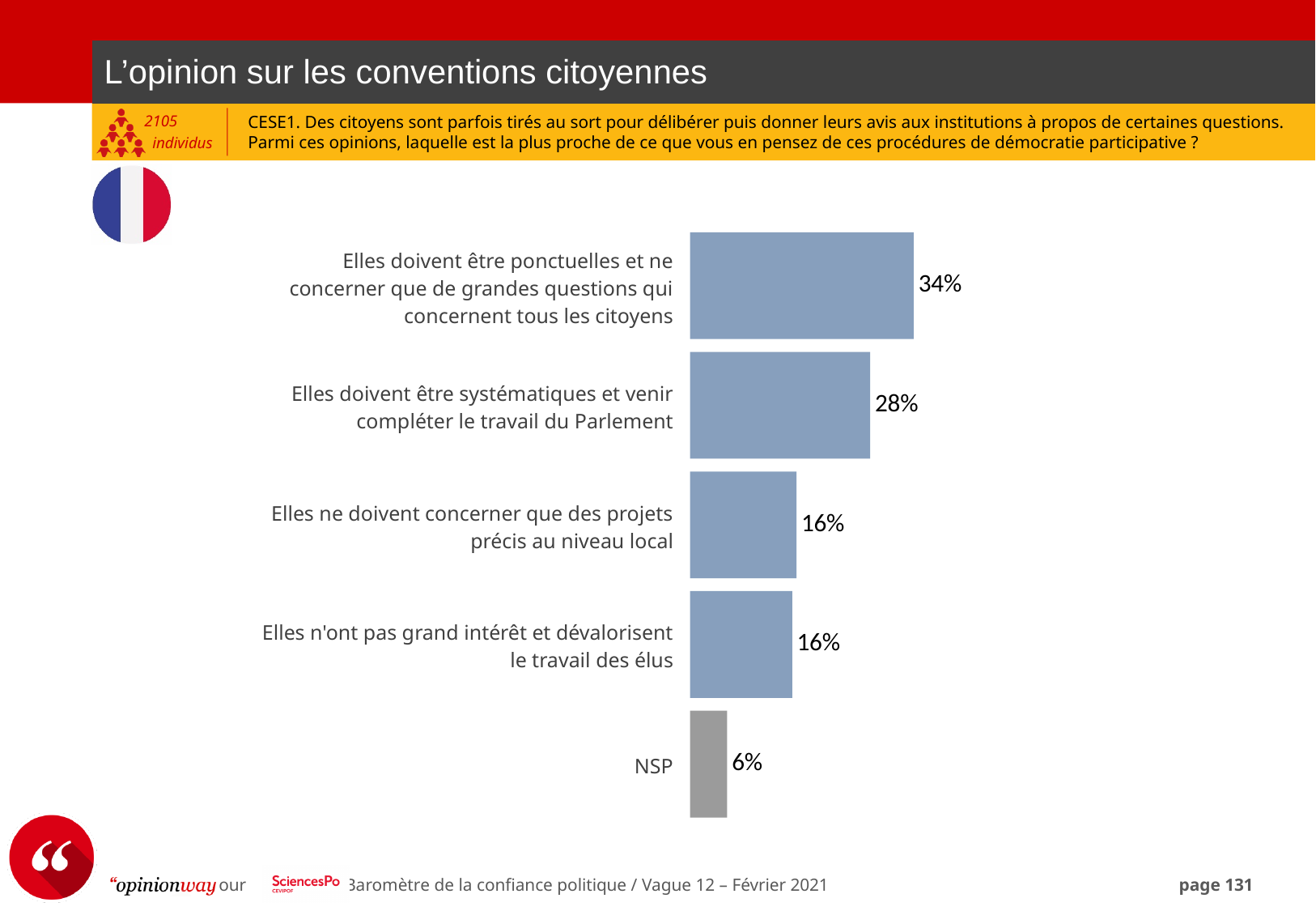
Which category has the highest value? Elles doivent être ponctuelles et ne concerner que de grandes questions qui concernent tous les citoyens What is the value for "Elles ne doivent concerner que des projets précis au niveau local"? 16% What kind of chart is shown on the slide? Bar chart What is the difference between the value for "Elles doivent être ponctuelles..." (34%) and "Elles doivent être systématiques..." (28%)? 6% What percentage of respondents chose "Elles doivent être ponctuelles et ne concerner que de grandes questions qui concernent tous les citoyens"? 34% What is the difference between the value for "Elles ne doivent concerner que des projets précis au niveau local" and NSP? 10% What percentage is shown for NSP? 6% Which bar is shown in a different colour (grey) from the others? NSP What is the value for "Elles doivent être systématiques et venir compléter le travail du Parlement"? 28% Which category has the lowest value? NSP Which is larger: the value for "Elles doivent être systématiques et venir compléter le travail du Parlement" or for "Elles n'ont pas grand intérêt et dévalorisent le travail des élus"? Elles doivent être systématiques et venir compléter le travail du Parlement How many categories are shown in the chart? 5